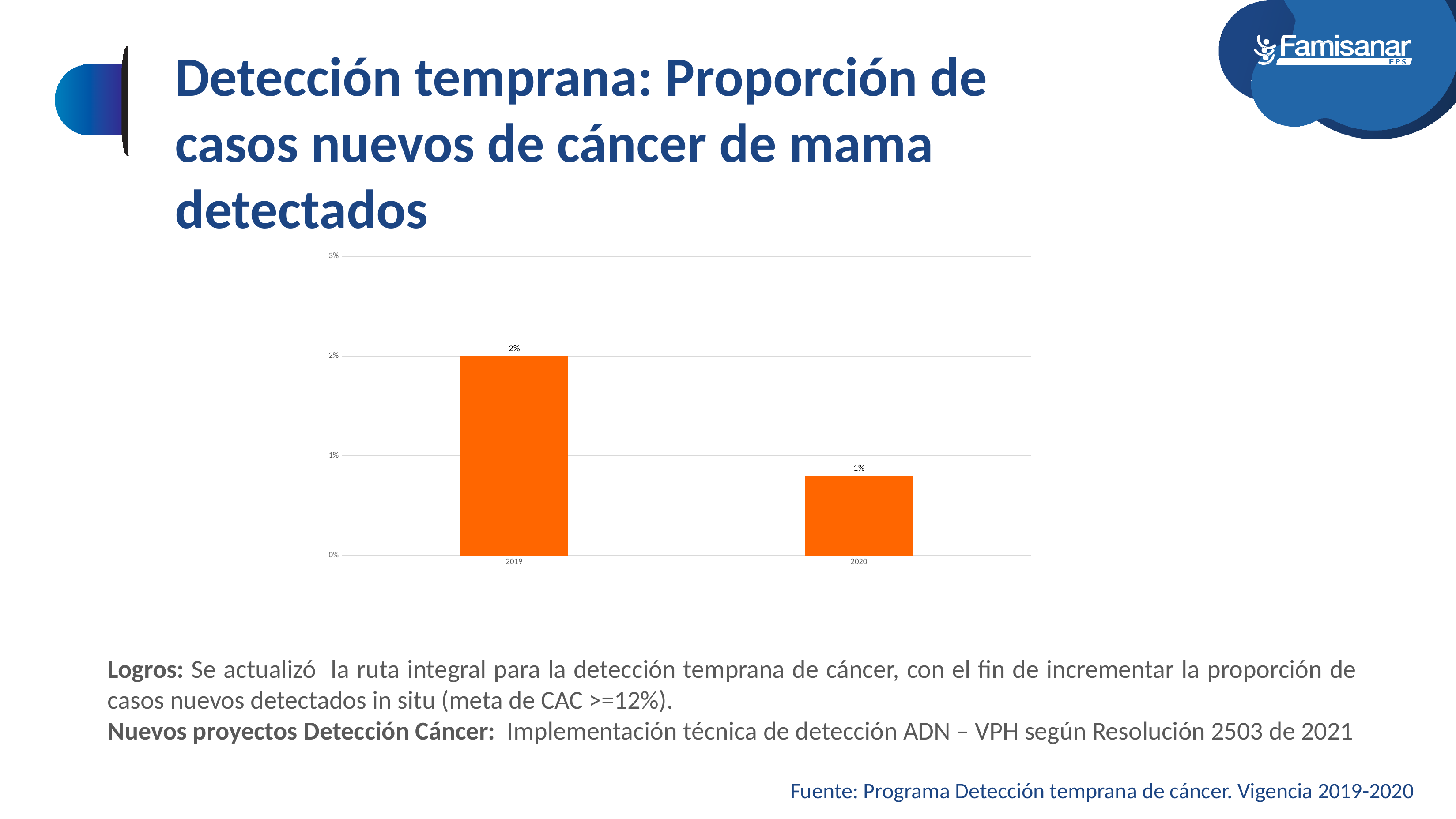
Is the value for 2019 greater or less than 1%? greater Which year has the lowest value? 2020 How many years are shown on the x axis? 2 What is the value shown for 2019? 2% What colour are the bars in the chart? orange What is the highest value labelled on the y axis? 3% What kind of chart is shown on the slide? bar chart Which year has the highest value? 2019 Which is larger, the value for 2019 or the value for 2020? 2019 Do the values rise or fall from 2019 to 2020? fall What is the value shown for 2020? 1% Is the value for 2019 greater or less than 3%? less